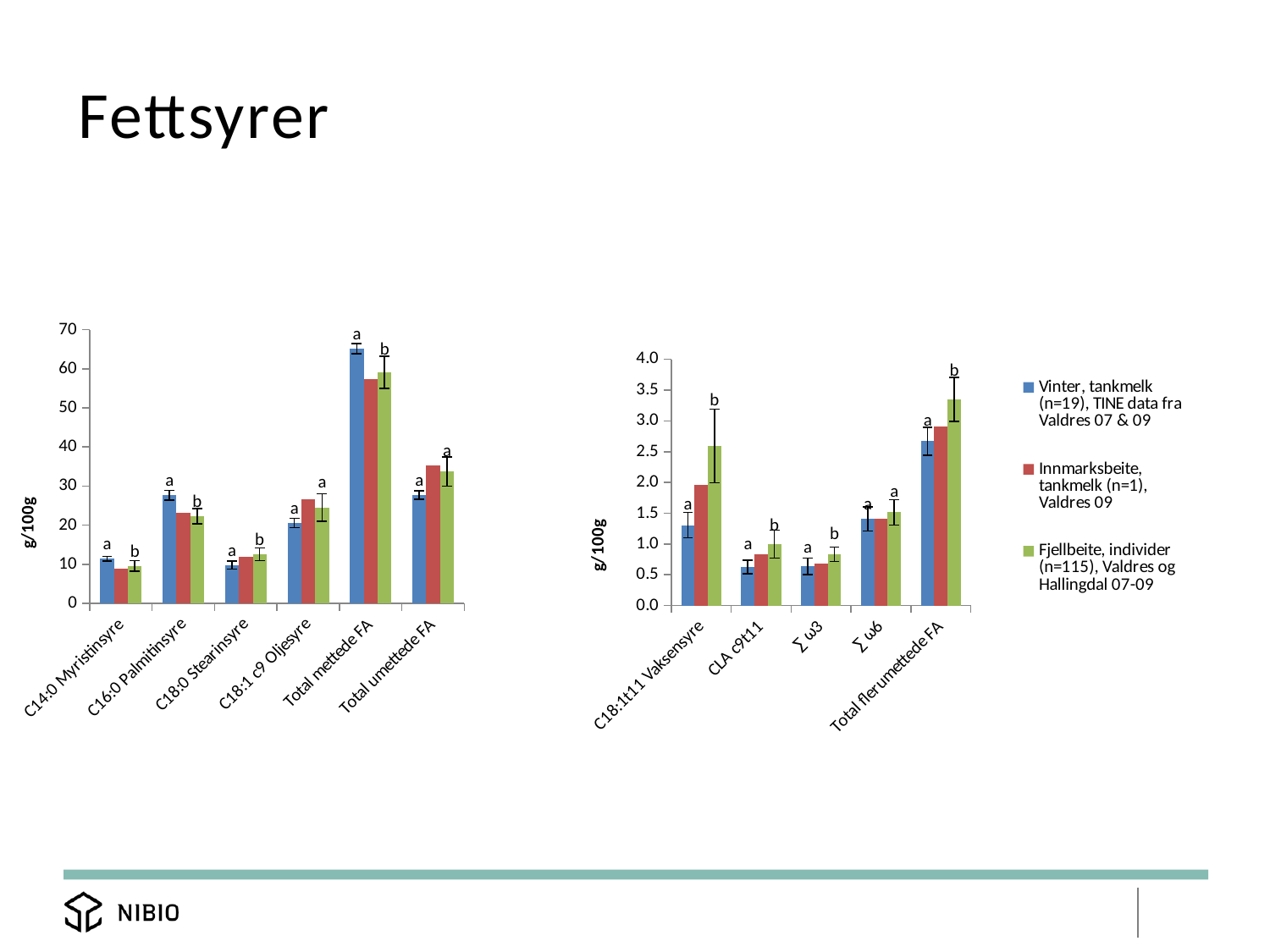
In the left chart, which category has the lowest bars? C14:0 Myristinsyre What is the y-axis label of the left chart? g/100g How many categories are shown on the x axis of the right chart? 5 In the right chart, is the value for Total flerumettede FA in the Fjellbeite, individer series greater or less than 3.0? greater In the right chart, is the value for CLA c9t11 in the Vinter, tankmelk series greater or less than 1.0? less In the left chart, is the value for C18:0 Stearinsyre in the Vinter, tankmelk series greater or less than 20? less How many categories are shown on the x axis of the left chart? 6 In the left chart, which category has the highest bars? Total mettede FA In the right chart, which category has the highest bars? Total flerumettede FA How many series does the legend list for the charts? 3 What kind of chart is the left chart on the slide? bar chart